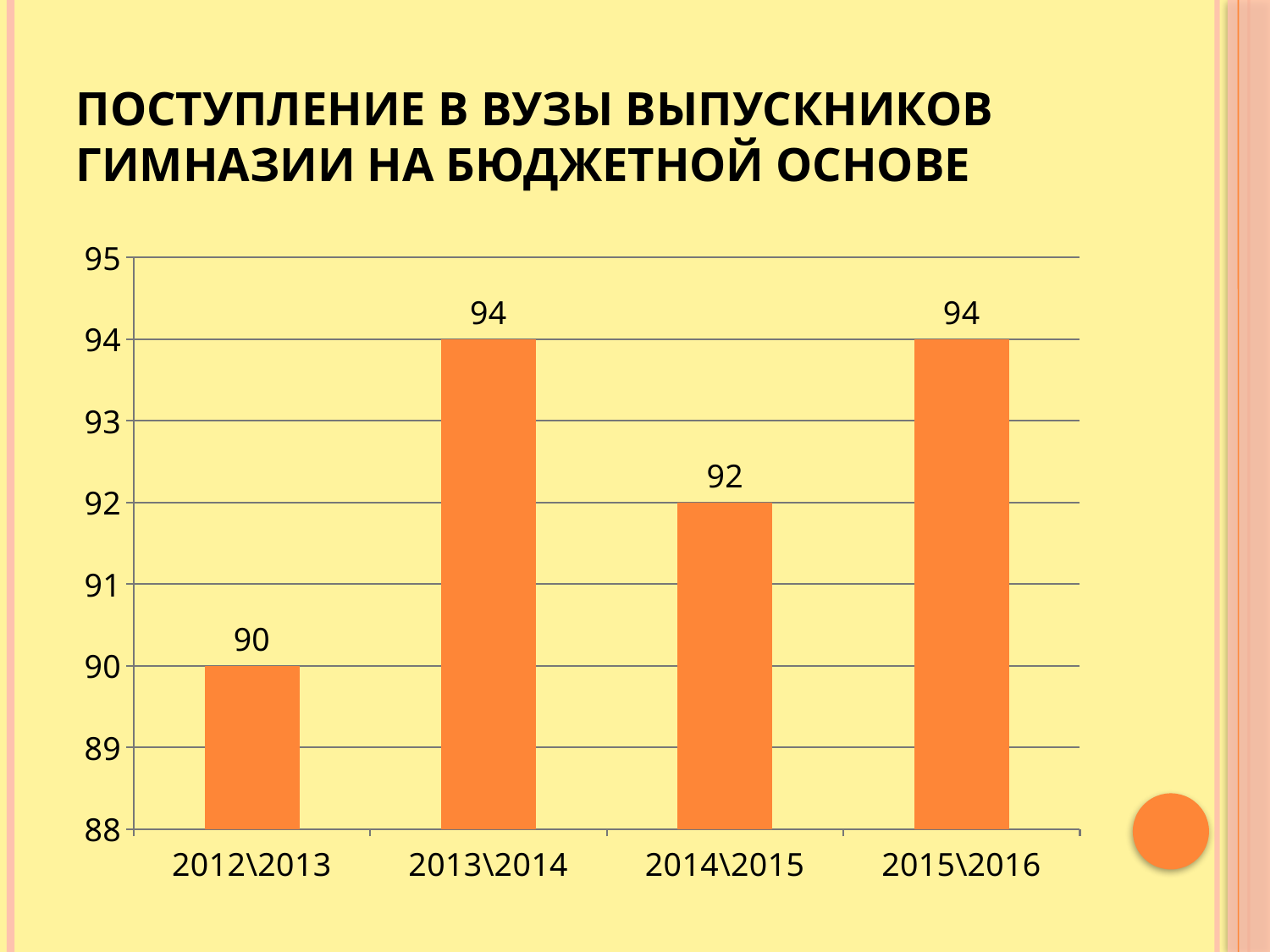
What is the difference between the values for 2013\2014 and 2012\2013? 4 What is the value for 2015\2016? 94 What kind of chart is shown on the slide? bar chart What is the value for 2014\2015? 92 Which is larger, the value for 2014\2015 or the value for 2012\2013? 2014\2015 Which category has the lowest value? 2012\2013 How many categories are shown on the x axis? 4 What is the value for 2013\2014? 94 What is the title of the slide? ПОСТУПЛЕНИЕ В ВУЗЫ ВЫПУСКНИКОВ ГИМНАЗИИ НА БЮДЖЕТНОЙ ОСНОВЕ What is the difference between the values for 2015\2016 and 2014\2015? 2 What is the value for 2012\2013? 90 Is the value for 2014\2015 greater or less than 91? greater